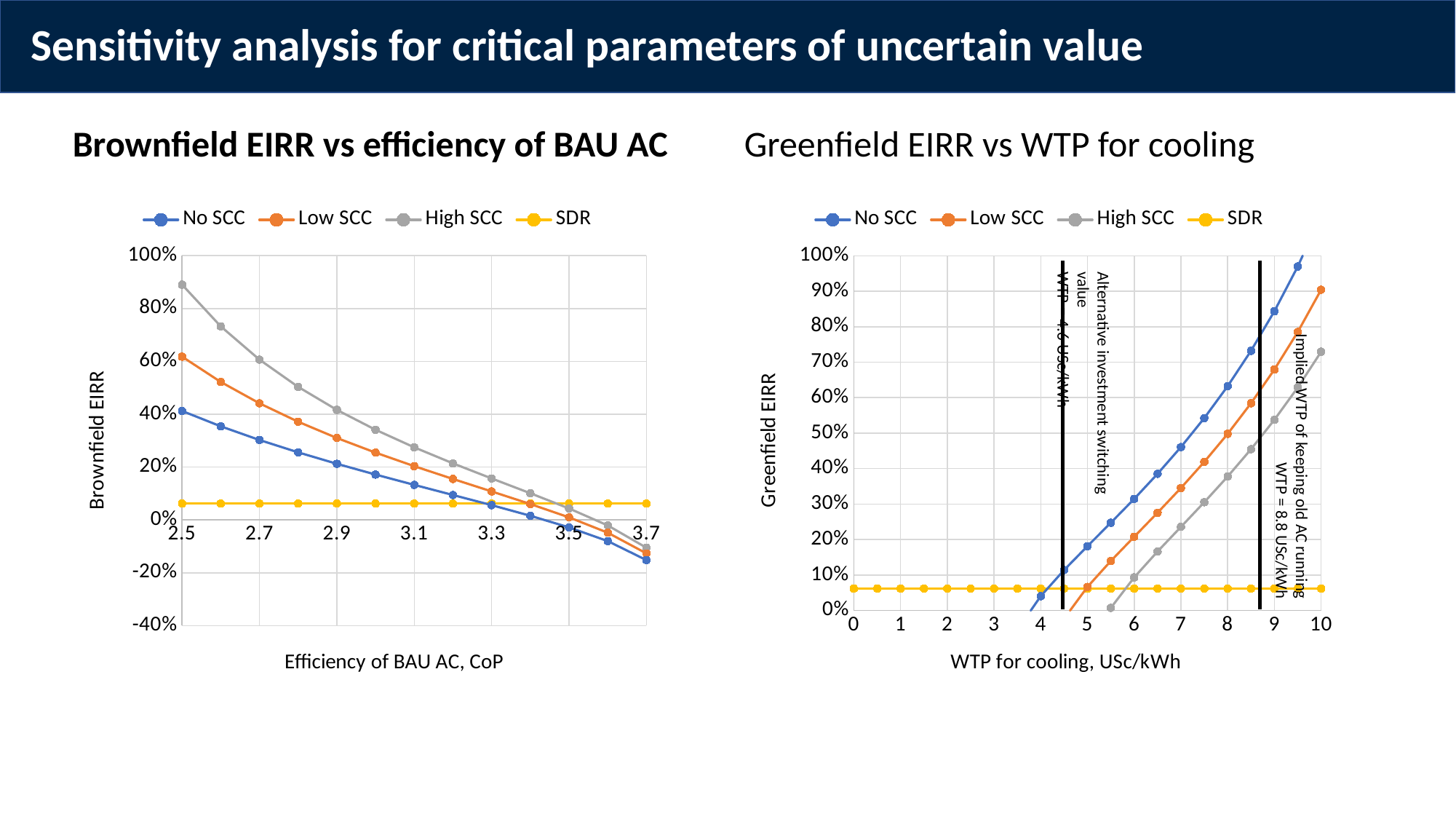
In the 'Brownfield EIRR vs efficiency of BAU AC' chart, is the No SCC value at efficiency 3.7 greater or less than 0%? less What is the x-axis title of the 'Greenfield EIRR vs WTP for cooling' chart? WTP for cooling, USc/kWh In the 'Brownfield EIRR vs efficiency of BAU AC' chart, which series has the highest value at an efficiency of 2.5? High SCC In the 'Brownfield EIRR vs efficiency of BAU AC' chart, which is larger at efficiency 2.9: High SCC or No SCC? High SCC In the 'Brownfield EIRR vs efficiency of BAU AC' chart, is the High SCC value at efficiency 2.5 greater or less than 80%? greater In the 'Greenfield EIRR vs WTP for cooling' chart, is the Low SCC value at a WTP of 10 greater or less than 80%? greater In the 'Greenfield EIRR vs WTP for cooling' chart, which is larger at a WTP of 8: No SCC or High SCC? No SCC What type of chart is the 'Brownfield EIRR vs efficiency of BAU AC' chart? line chart In the 'Brownfield EIRR vs efficiency of BAU AC' chart, does the No SCC series rise or fall as efficiency increases from 2.5 to 3.7? fall How many series does the legend of the 'Greenfield EIRR vs WTP for cooling' chart list? 4 In the 'Greenfield EIRR vs WTP for cooling' chart, what WTP value is marked as the alternative investment switching value? 4.5 USc/kWh In the 'Greenfield EIRR vs WTP for cooling' chart, does the Low SCC series rise or fall as WTP increases? rise